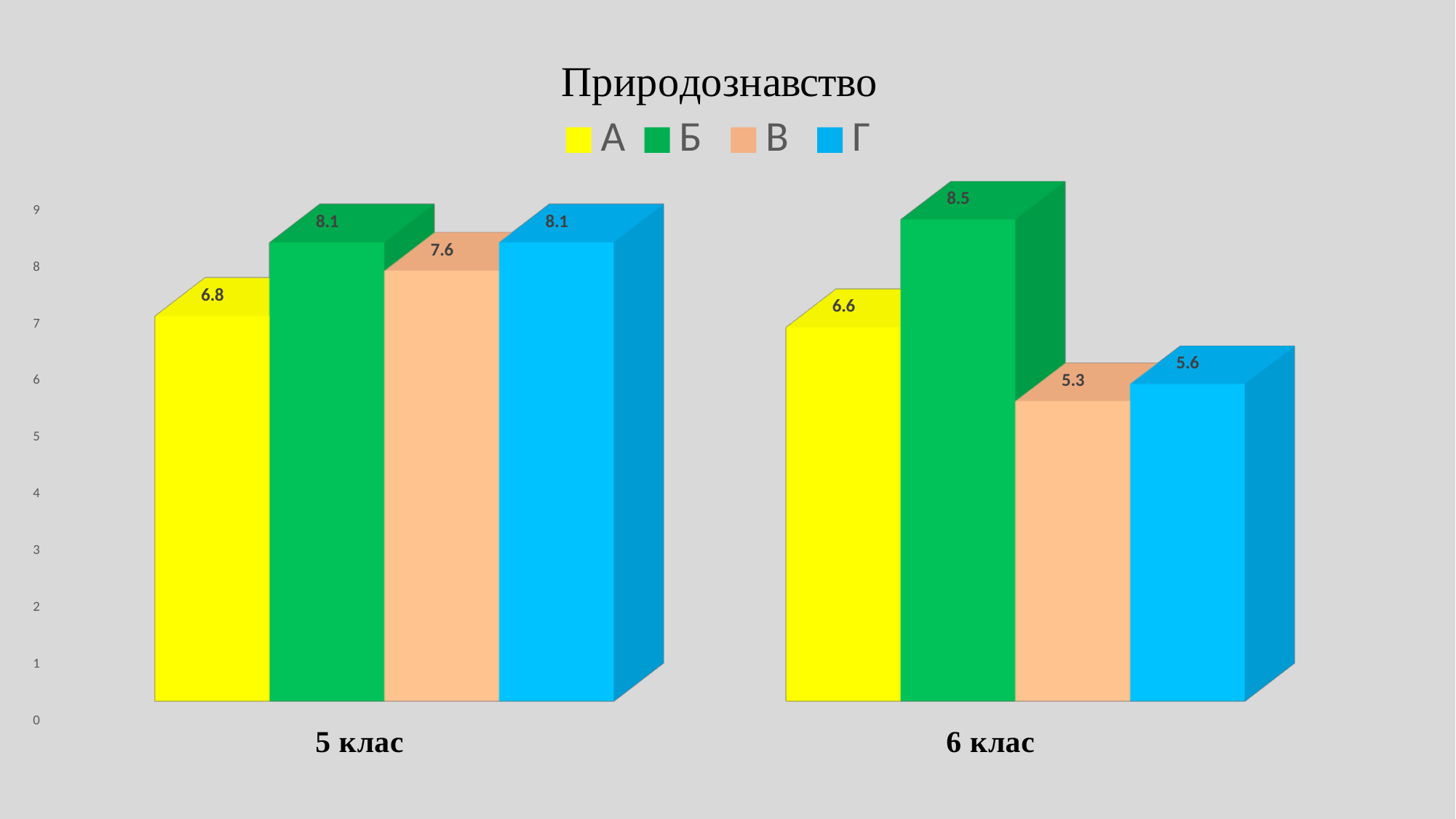
What is the difference between the values for series Б and series В in the 6 клас category? 3.2 How many series does the legend list? 4 Which is larger: the value for series А in 5 клас or in 6 клас? 5 клас Which series has the highest value in the 6 клас category? Б What is the value for series Б in the 5 клас category? 8.1 Which series has the lowest value in the 6 клас category? В How many categories are shown on the x axis? 2 Which series has the lowest value in the 5 клас category? А What is the value for series Г in the 6 клас category? 5.6 What is the value for series А in the 5 клас category? 6.8 What is the title of the chart? Природознавство What is the value for series В in the 6 клас category? 5.3